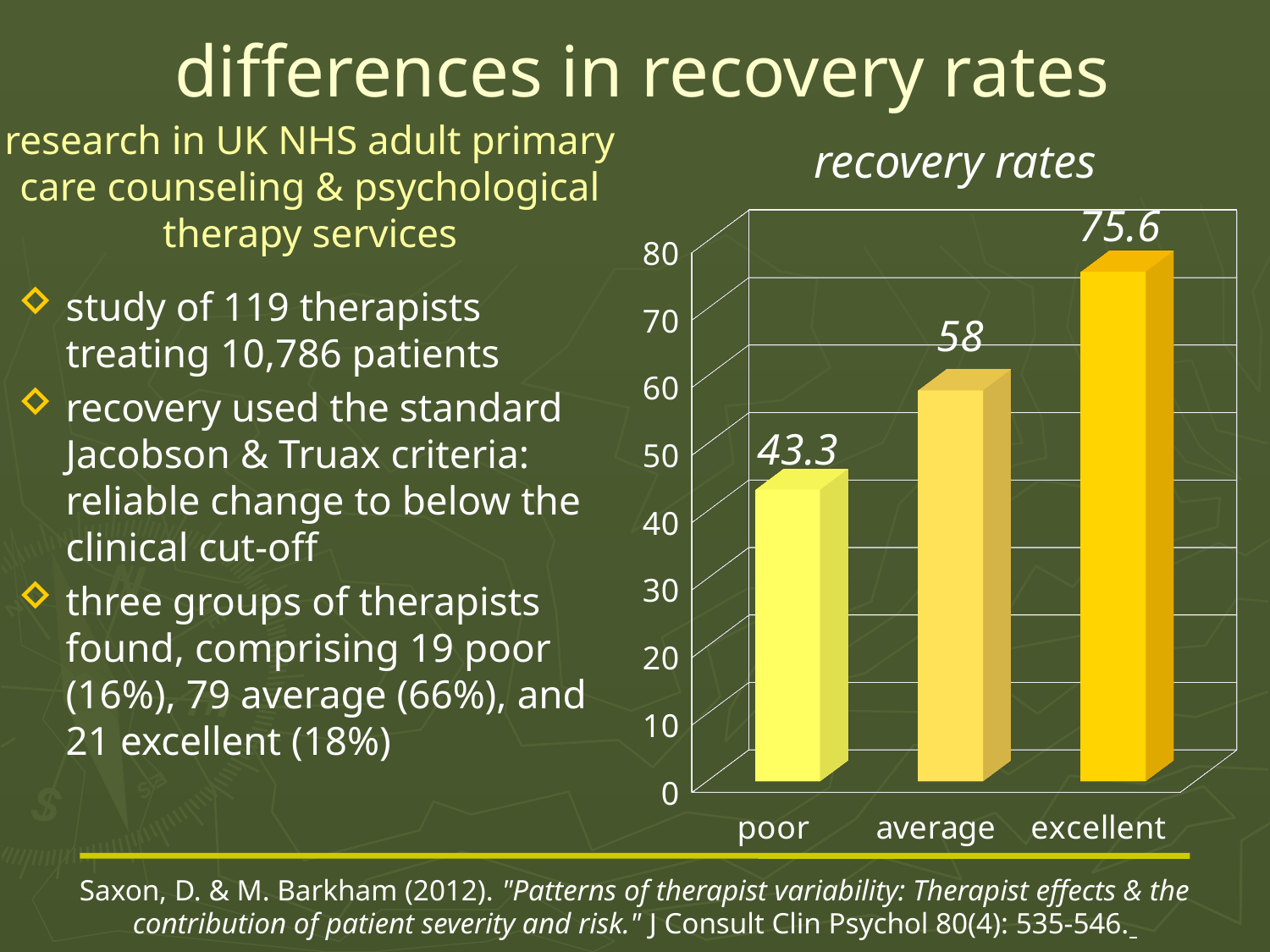
What is the title of the chart? recovery rates What is the recovery rate for the excellent therapist group? 75.6 What kind of chart is used to show the recovery rates? bar chart Which therapist group has the highest recovery rate? excellent What is the recovery rate for the poor therapist group? 43.3 What is the difference between the recovery rates of the average and poor groups? 14.7 Which has a higher recovery rate, the average group or the poor group? average What is the difference between the recovery rates of the excellent and poor groups? 32.3 What is the recovery rate for the average therapist group? 58 Is the recovery rate for the average group greater or less than 50? greater How many therapist groups are shown in the chart? 3 Which therapist group has the lowest recovery rate? poor